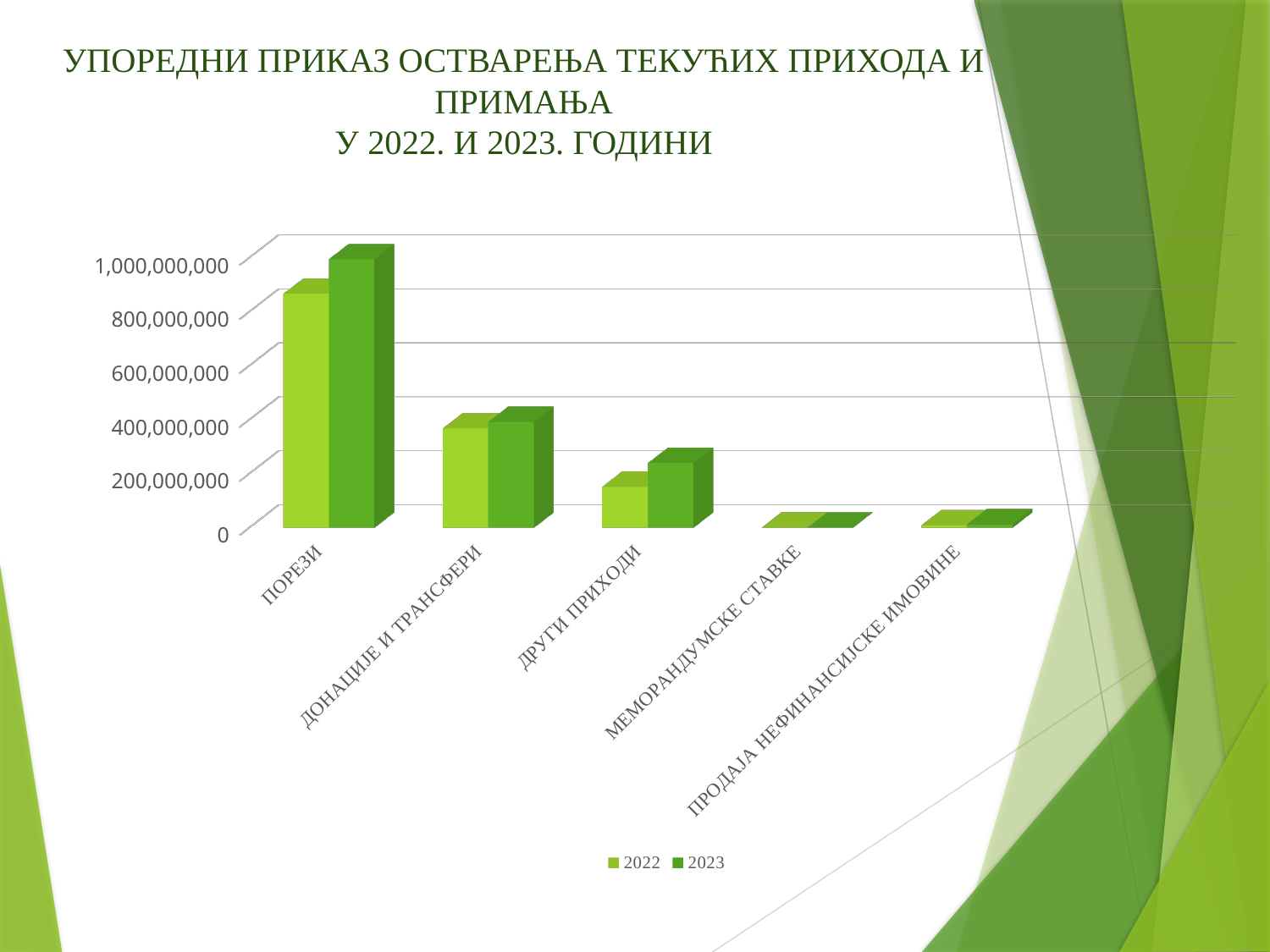
How many categories are shown on the x axis? 5 For ДРУГИ ПРИХОДИ, which year has the larger value, 2022 or 2023? 2023 What kind of chart is shown on the slide? bar chart Which category has the highest value for 2022? ПОРЕЗИ Is the 2022 value for ДРУГИ ПРИХОДИ greater or less than 200,000,000? less How many series does the legend list? 2 Is the 2022 value for ДОНАЦИЈЕ И ТРАНСФЕРИ greater or less than 600,000,000? less Is the 2022 value for ПОРЕЗИ greater or less than 600,000,000? greater For ПОРЕЗИ, which year has the larger value, 2022 or 2023? 2023 Do the 2023 values generally rise or fall moving from left to right along the x axis? fall Which category has the highest value for 2023? ПОРЕЗИ What are the two entries listed in the legend? 2022 and 2023